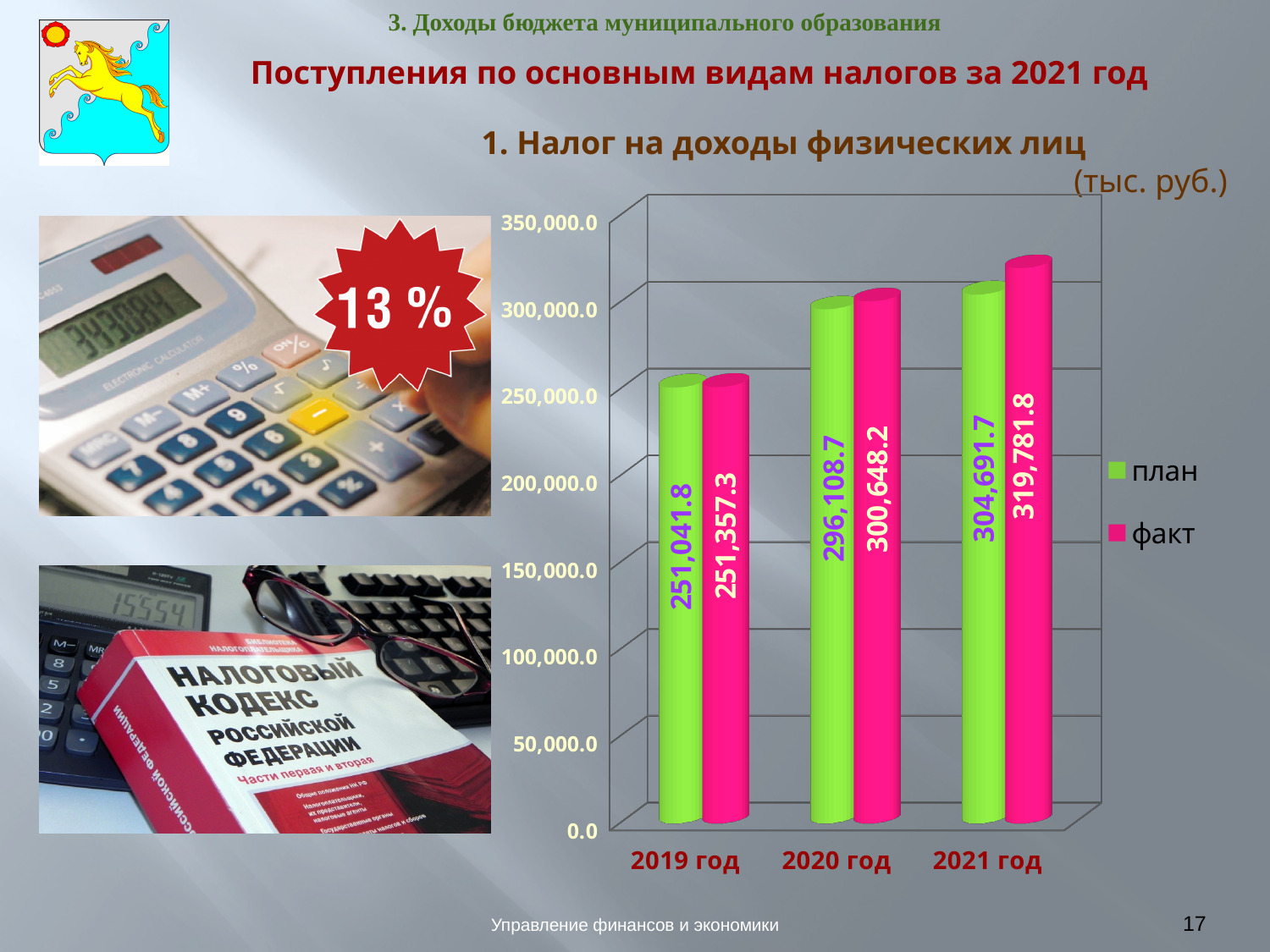
Which year has the highest факт value? 2021 год Is the план value for 2019 год greater or less than 300,000.0? less How many years are shown on the x axis? 3 Which is larger for 2021 год, план or факт? факт Which year has the lowest план value? 2019 год What is the факт value for 2021 год? 319,781.8 What is the difference between факт and план for 2020 год? 4,539.5 What is the difference between факт and план for 2021 год? 15,090.1 How many series does the legend list? 2 What is the план value for 2020 год? 296,108.7 What is the факт value for 2019 год? 251,357.3 Do the факт values rise or fall from 2019 год to 2021 год? rise